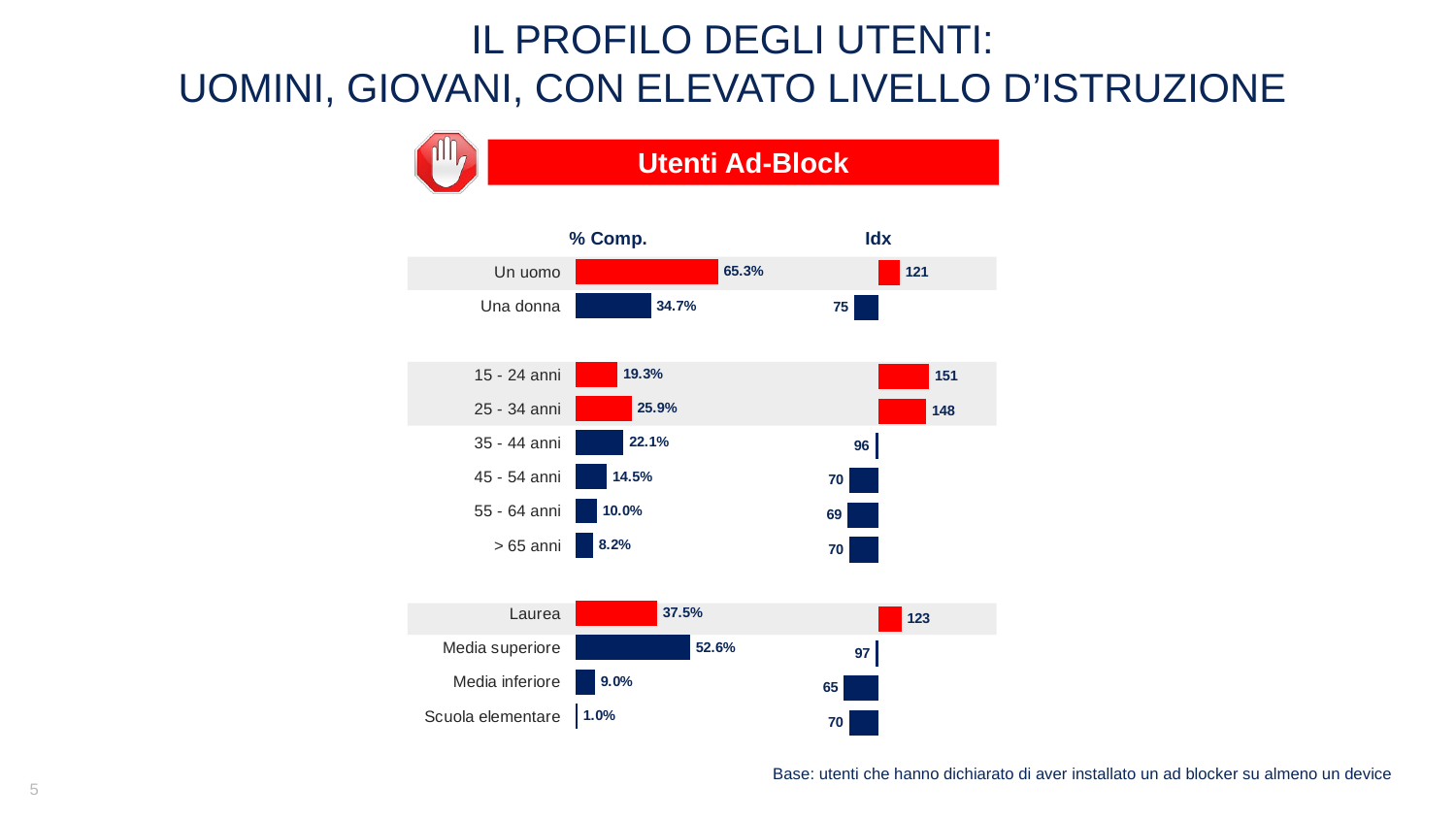
In the % Comp. chart, do the values rise or fall from 25 - 34 anni to > 65 anni? fall In the Idx chart, what is the value for Media inferiore? 65 In the % Comp. chart, what is the value for Un uomo? 65.3% In the % Comp. chart, what is the difference between Un uomo and Una donna? 30.6% What kind of chart is the Idx chart? bar chart In the Idx chart, what is the value for 15 - 24 anni? 151 How many categories are shown in the % Comp. chart? 12 In the Idx chart, what is the difference between Laurea and Media superiore? 26 In the % Comp. chart, what is the value for Media superiore? 52.6% In the Idx chart, which category has the highest value? 15 - 24 anni In the % Comp. chart, which is larger: 25 - 34 anni or 35 - 44 anni? 25 - 34 anni In the % Comp. chart, which category has the lowest value? Scuola elementare